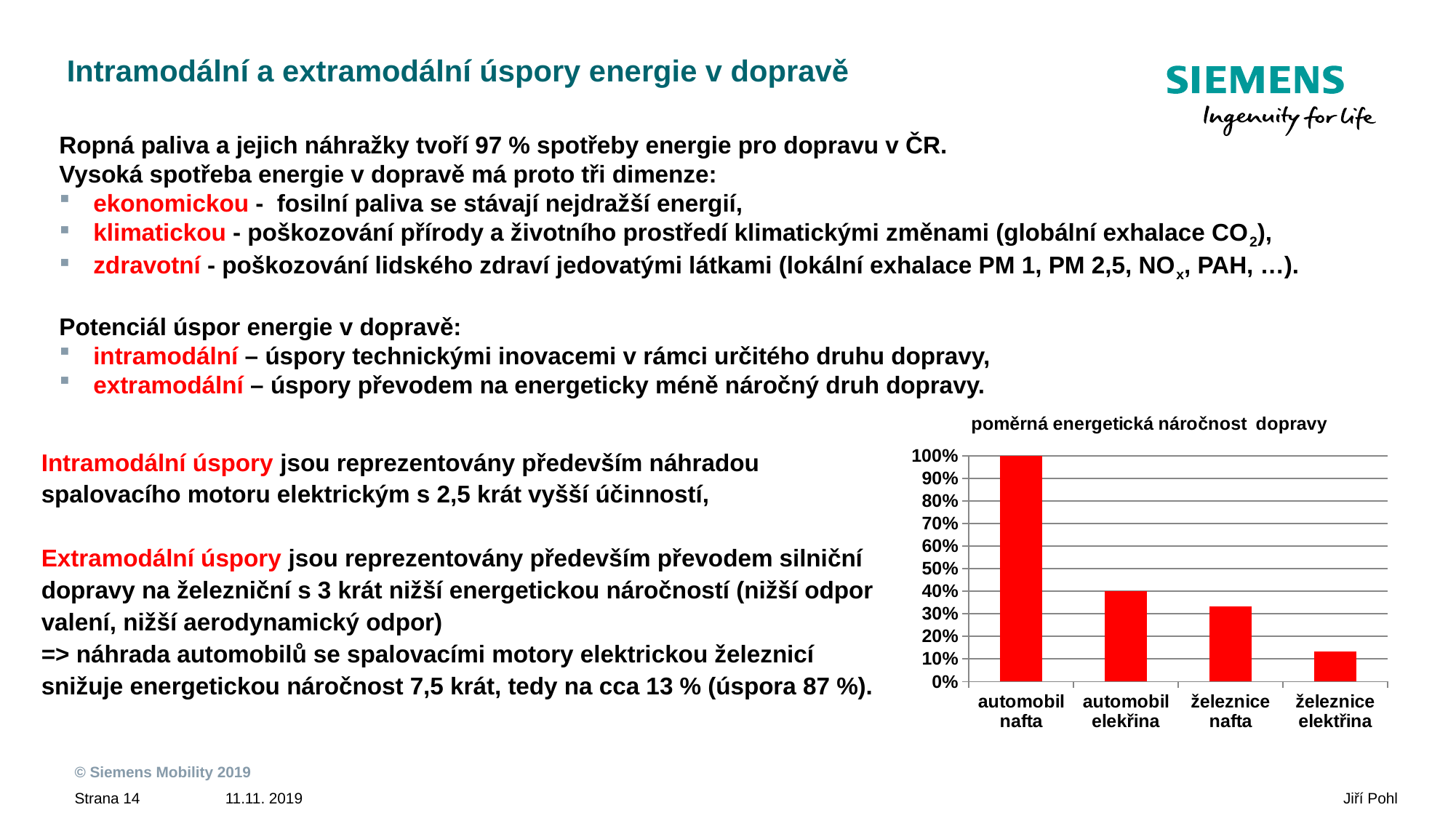
What is the value for automobil elekřina? 40% Do the values rise or fall from left to right along the x axis? fall What colour are the bars in the chart? red Is the value for železnice nafta greater or less than 40%? less What is the value for automobil nafta? 100% Which category has the highest value in the chart? automobil nafta What kind of chart is shown on the slide? bar chart Which category has the lowest value in the chart? železnice elektřina Which is larger, the value for automobil elekřina or the value for železnice nafta? automobil elekřina How many categories are shown on the x axis of the chart? 4 What is the title of the chart? poměrná energetická náročnost dopravy Is the value for železnice elektřina greater or less than 10%? greater